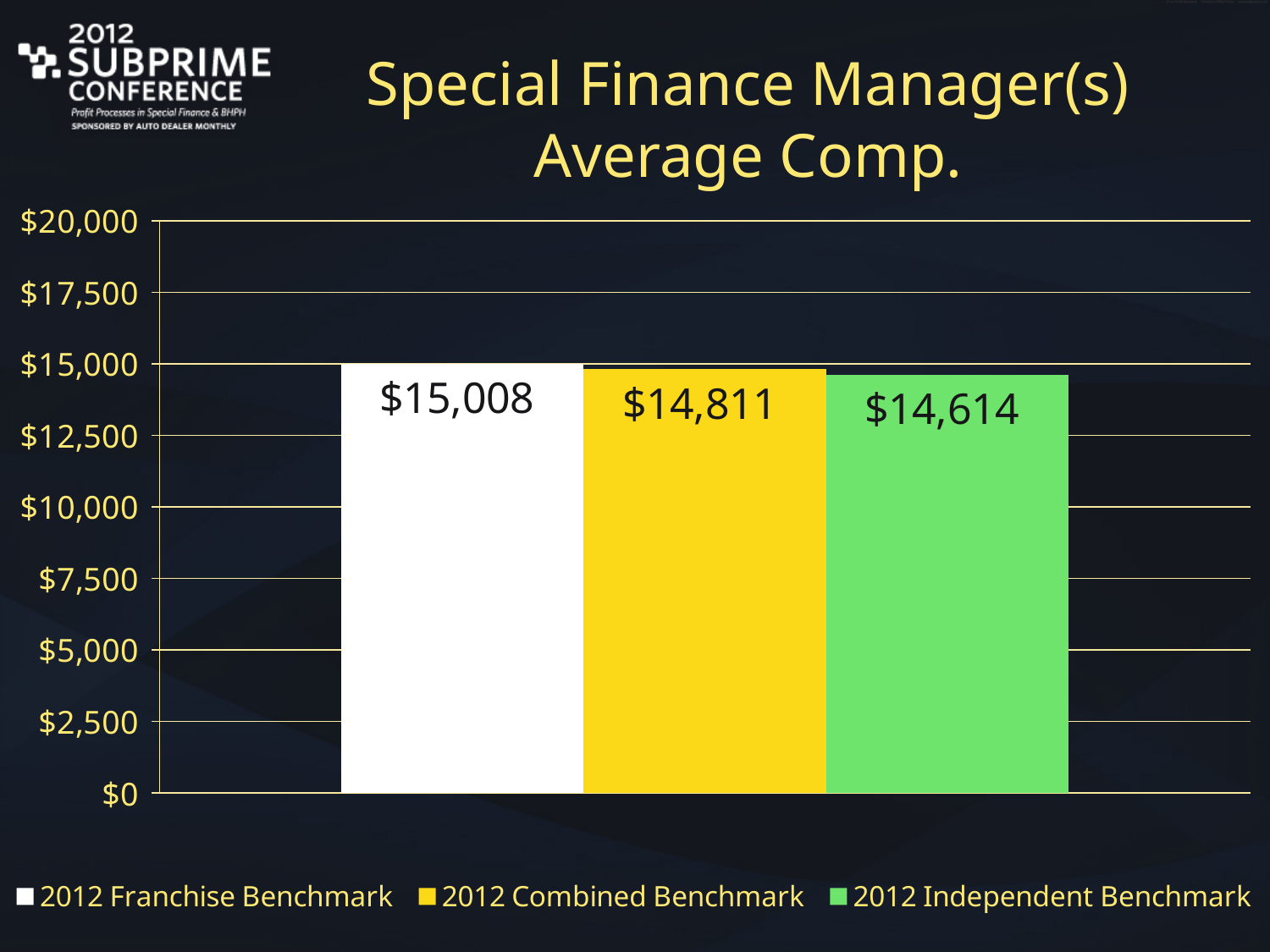
What is the value for 2012 Franchise Benchmark? $15,008 Is the value for 2012 Independent Benchmark greater or less than $15,000? less Which series has the highest value? 2012 Franchise Benchmark What is the value for 2012 Independent Benchmark? $14,614 Which series has the lowest value? 2012 Independent Benchmark What kind of chart is shown on the slide? bar chart What is the difference between the 2012 Franchise Benchmark and the 2012 Combined Benchmark values? $197 What is the difference between the 2012 Franchise Benchmark and the 2012 Independent Benchmark values? $394 What is the value for 2012 Combined Benchmark? $14,811 What is the title of the chart? Special Finance Manager(s) Average Comp. Which is larger, the 2012 Combined Benchmark or the 2012 Independent Benchmark? 2012 Combined Benchmark How many series does the legend list? 3